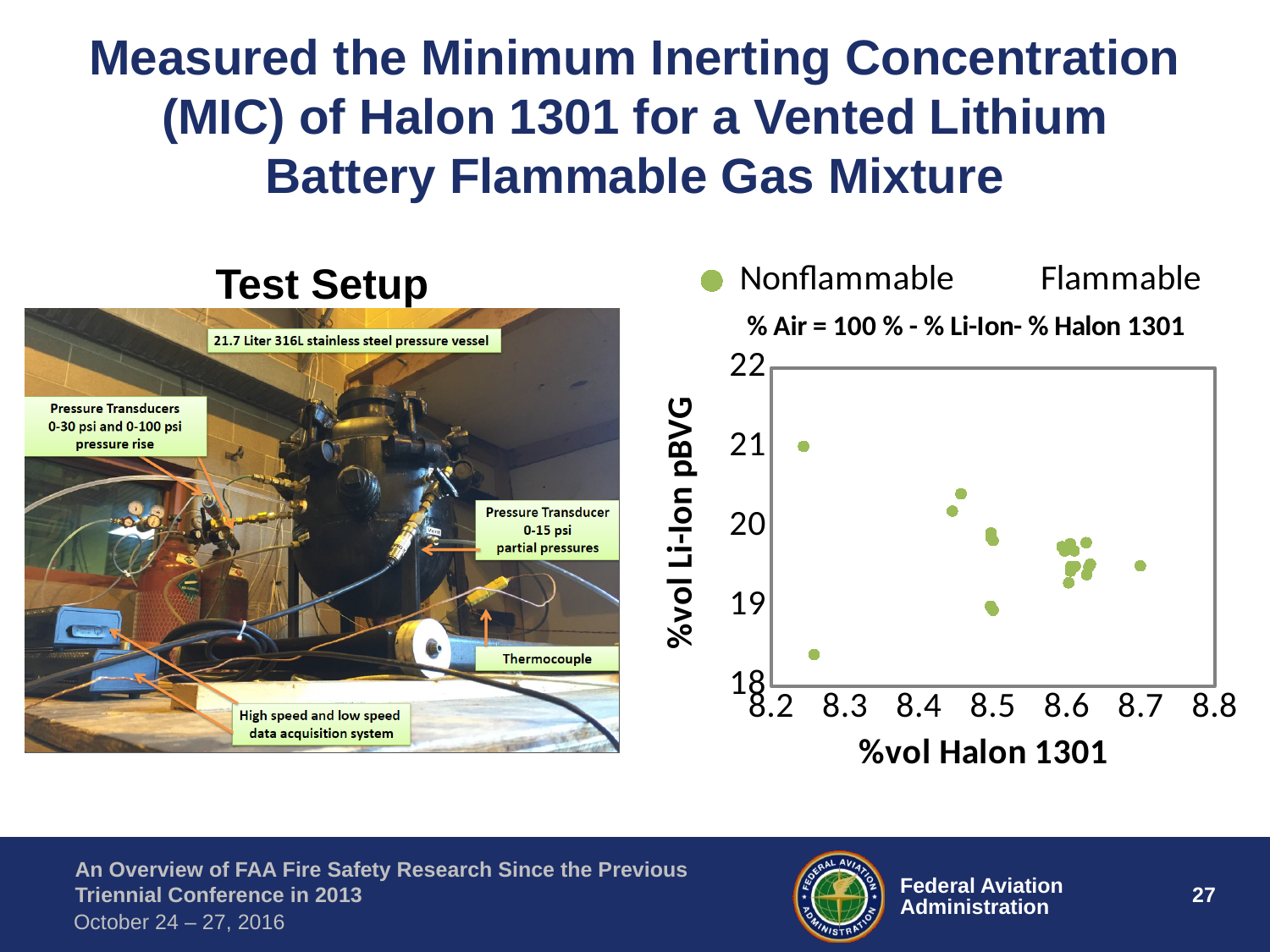
In the scatter chart, is the %vol Li-Ion pBVG value of the rightmost point (near 8.7 %vol Halon 1301) greater or less than 19? greater In the scatter chart, is the %vol Li-Ion pBVG value of the highest point greater or less than 20? greater What is the label of the x axis of the scatter chart? %vol Halon 1301 In the scatter chart, is the %vol Li-Ion pBVG value of the lowest point greater or less than 19? less In the scatter chart, is the highest point located at the left or the right end of the x axis range? left How many series does the legend of the scatter chart list? 2 In the scatter chart, which has the higher %vol Li-Ion pBVG value: the rightmost point near 8.7 %vol Halon 1301 or the lowest point near 8.25 %vol Halon 1301? the rightmost point near 8.7 What is the label of the y axis of the scatter chart? %vol Li-Ion pBVG What kind of chart is shown on the right side of the slide? scatter chart